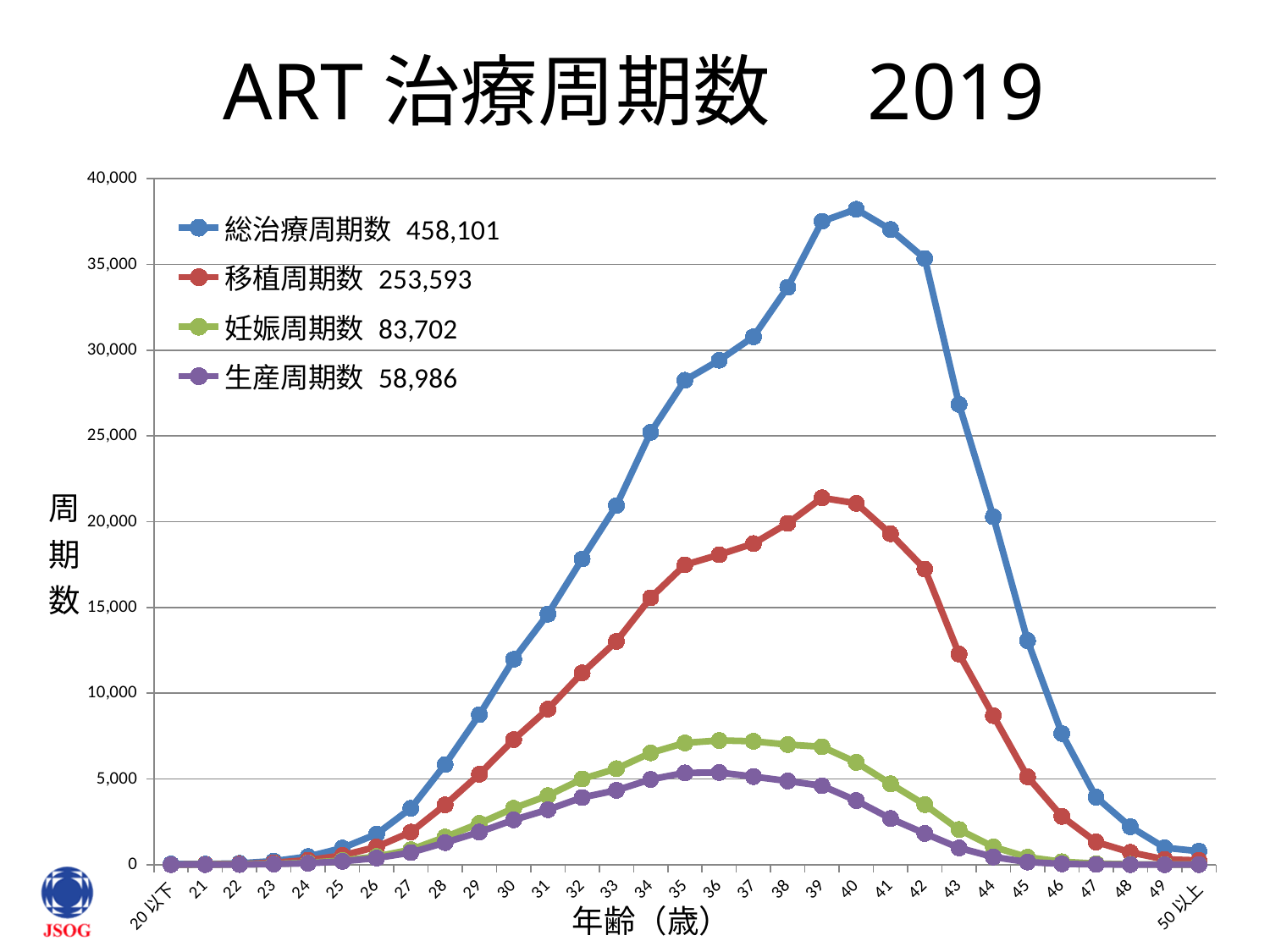
Is the value for 移植周期数 at age 43 greater or less than 10,000? greater Which series has the smallest total shown in the legend? 生産周期数 How many series does the legend list? 4 Which legend total is larger, 移植周期数 or 妊娠周期数? 移植周期数 What total is shown in the legend for 妊娠周期数? 83,702 Is the value for 総治療周期数 at age 40 greater or less than 35,000? greater How many age categories are plotted along the x axis? 31 What kind of chart is shown on the slide? line chart Does the 総治療周期数 line rise or fall from age 40 to 50以上? fall Which series has the largest total shown in the legend? 総治療周期数 What is the difference between the legend totals for 総治療周期数 and 移植周期数? 204,508 What total is shown in the legend for 総治療周期数? 458,101